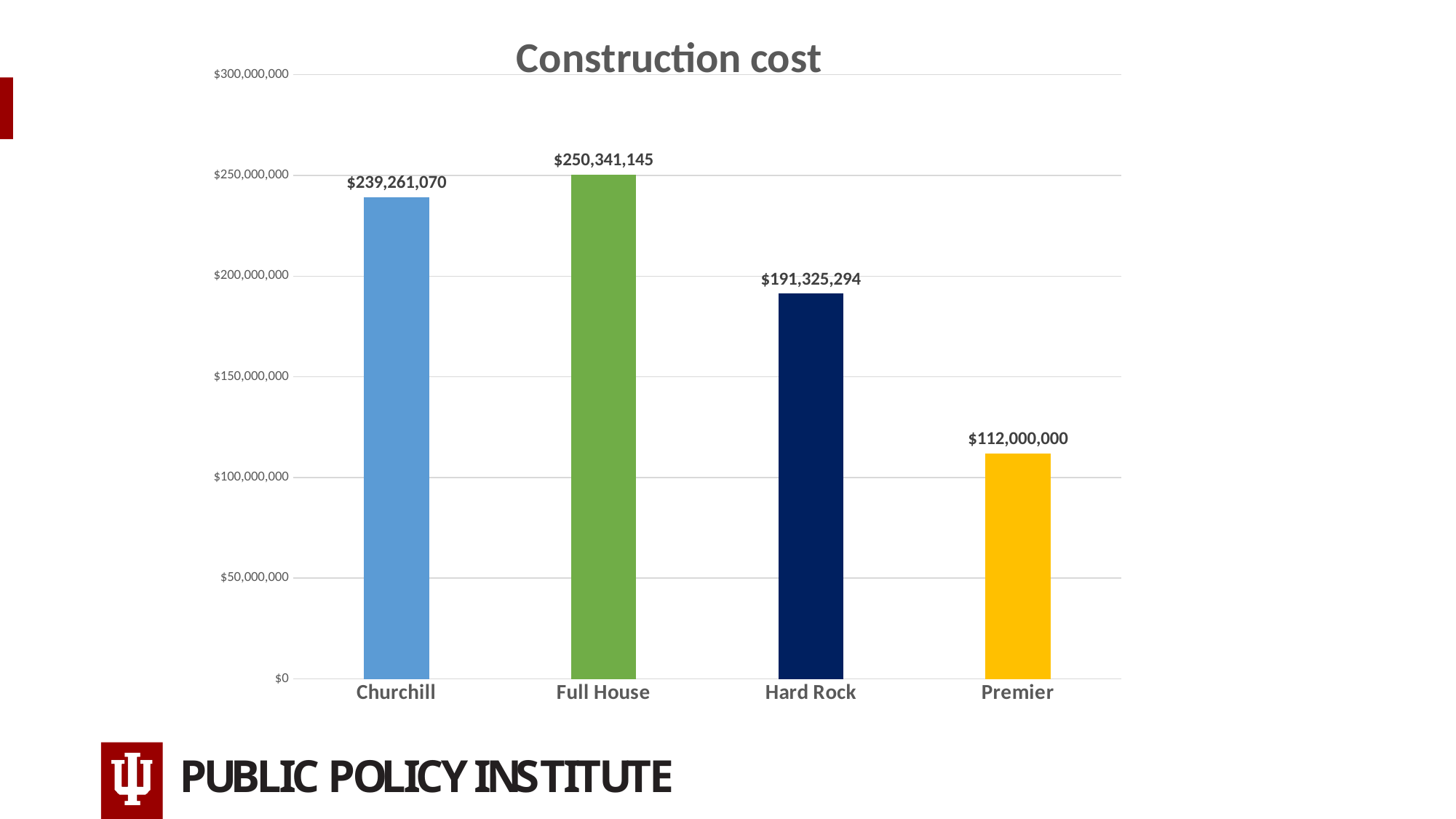
Which has a higher construction cost, Churchill or Hard Rock? Churchill What is the difference in construction cost between Full House and Churchill? $11,080,075 What is the difference in construction cost between Hard Rock and Premier? $79,325,294 Which category has the lowest construction cost? Premier Which category has the highest construction cost? Full House Is the construction cost for Premier greater or less than $150,000,000? less What type of chart is shown on the slide? Bar chart How many categories are shown in the chart? 4 What is the construction cost for Hard Rock? $191,325,294 What is the construction cost for Churchill? $239,261,070 What is the construction cost for Premier? $112,000,000 What is the construction cost for Full House? $250,341,145